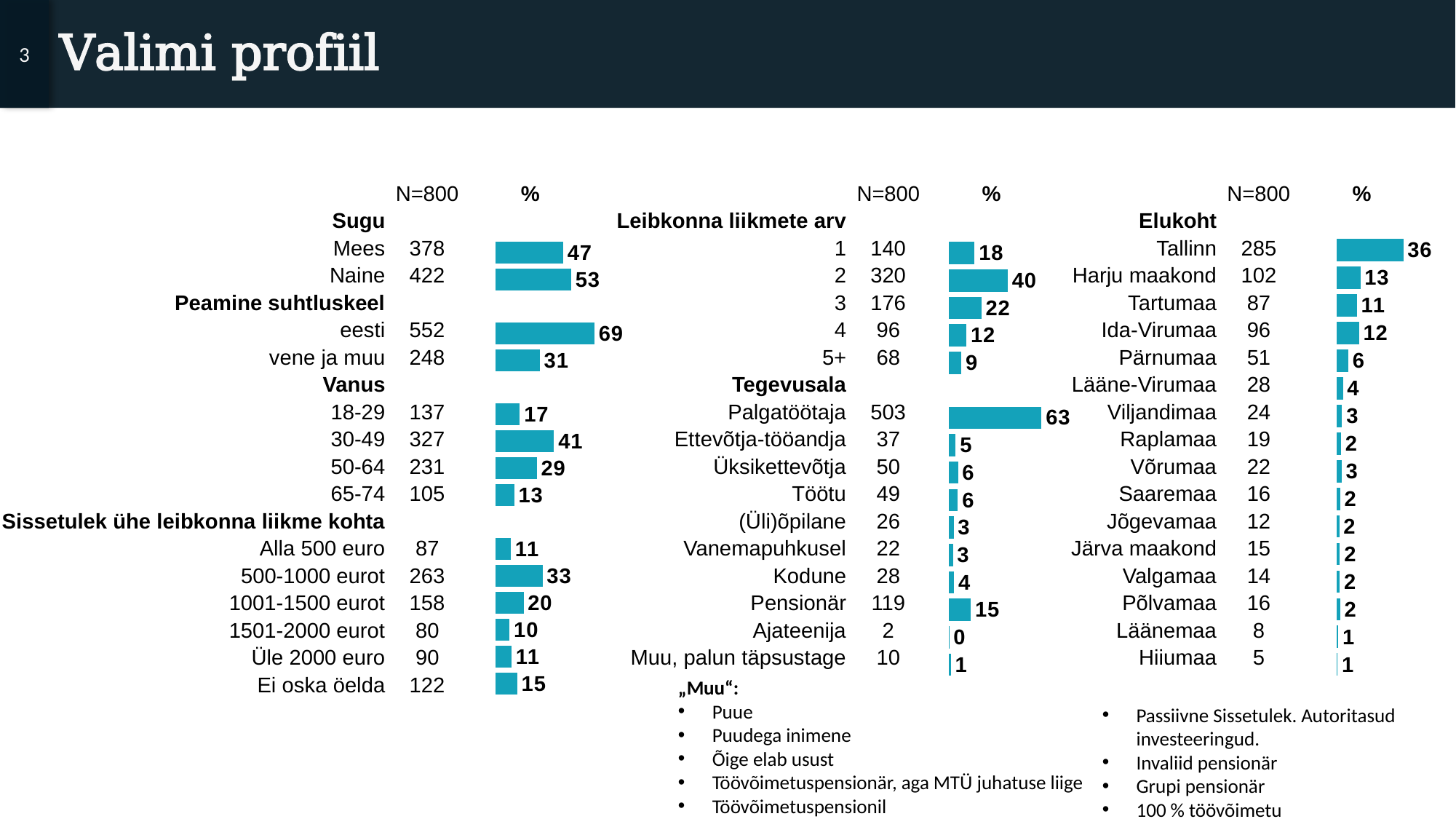
What type of chart is used on this slide? Bar chart In the right chart (Elukoht), what is the difference in percentage between Tallinn and Harju maakond? 23 In the left chart, which Vanus age group has the highest percentage? 30-49 In the middle chart, what percentage is shown for households with 2 members (Leibkonna liikmete arv = 2)? 40 In the left chart, what percentage is shown for eesti under Peamine suhtluskeel? 69 In the middle chart, which Tegevusala category has the highest percentage? Palgatöötaja In the middle chart, which is larger: the percentage for Töötu or for Kodune? Töötu In the left chart, what percentage is shown for Naine? 53 How many Elukoht categories are shown in the right chart? 16 In the left chart, what is the difference in percentage between 30-49 and 65-74? 28 In the middle chart, what percentage is shown for Pensionär? 15 In the right chart (Elukoht), what percentage is shown for Tallinn? 36